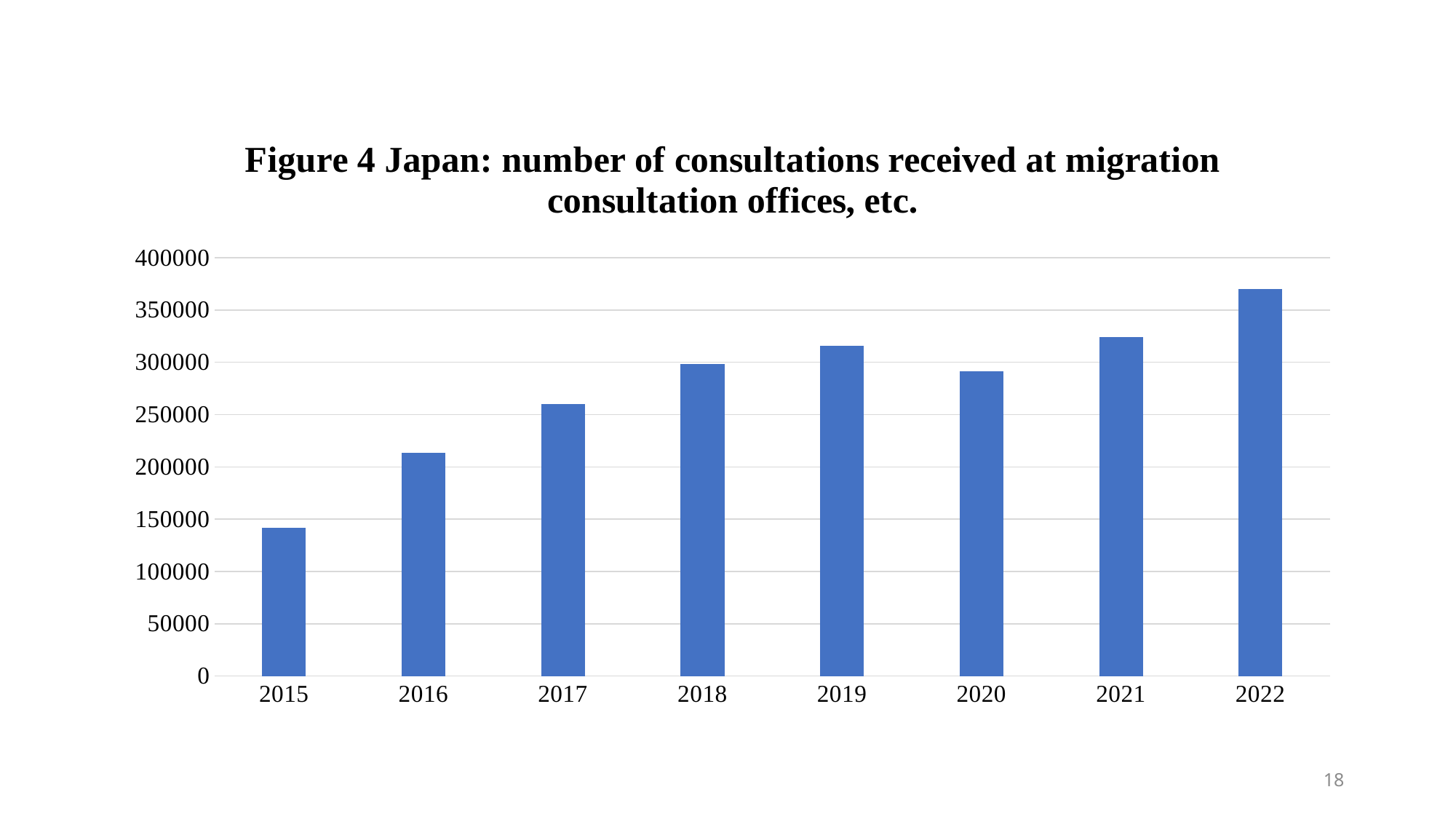
Which year has the larger value, 2019 or 2020? 2019 How many years are shown on the x axis of the chart? 8 Which year has the larger value, 2017 or 2020? 2020 Is the value for 2015 greater or less than 150000? less Is the value for 2019 greater or less than 300000? greater Do the values generally rise or fall from 2015 to 2022? Rise What is the title of the chart? Figure 4 Japan: number of consultations received at migration consultation offices, etc. Is the value for 2016 greater or less than 200000? greater Which year has the lowest number of consultations? 2015 What kind of chart is shown on the slide? Bar chart Which year has the highest number of consultations? 2022